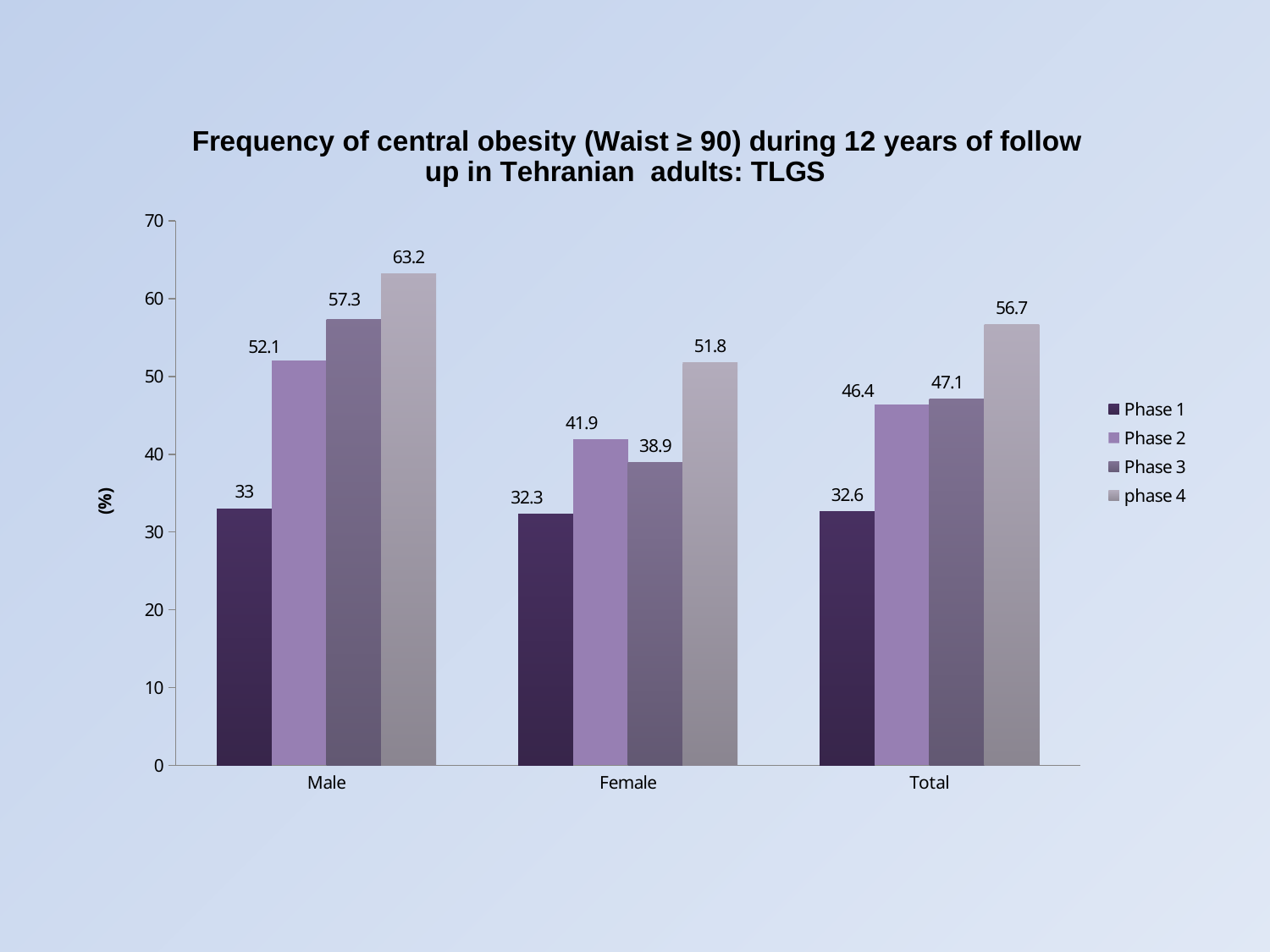
Which phase has the lowest value in the Female category? Phase 1 What is the label of the y axis? (%) Which is larger for Female: Phase 2 or Phase 3? Phase 2 Is the value for Phase 2 in the Total category greater or less than 40? greater What is the value for Phase 1 in the Male category? 33 Which category has the highest phase 4 value? Male How many series does the legend list? 4 How many categories are shown on the x axis? 3 What is the difference between the phase 4 and Phase 1 values for Male? 30.2 What is the value for phase 4 in the Female category? 51.8 What is the value for Phase 3 in the Total category? 47.1 What kind of chart is shown on the slide? Bar chart